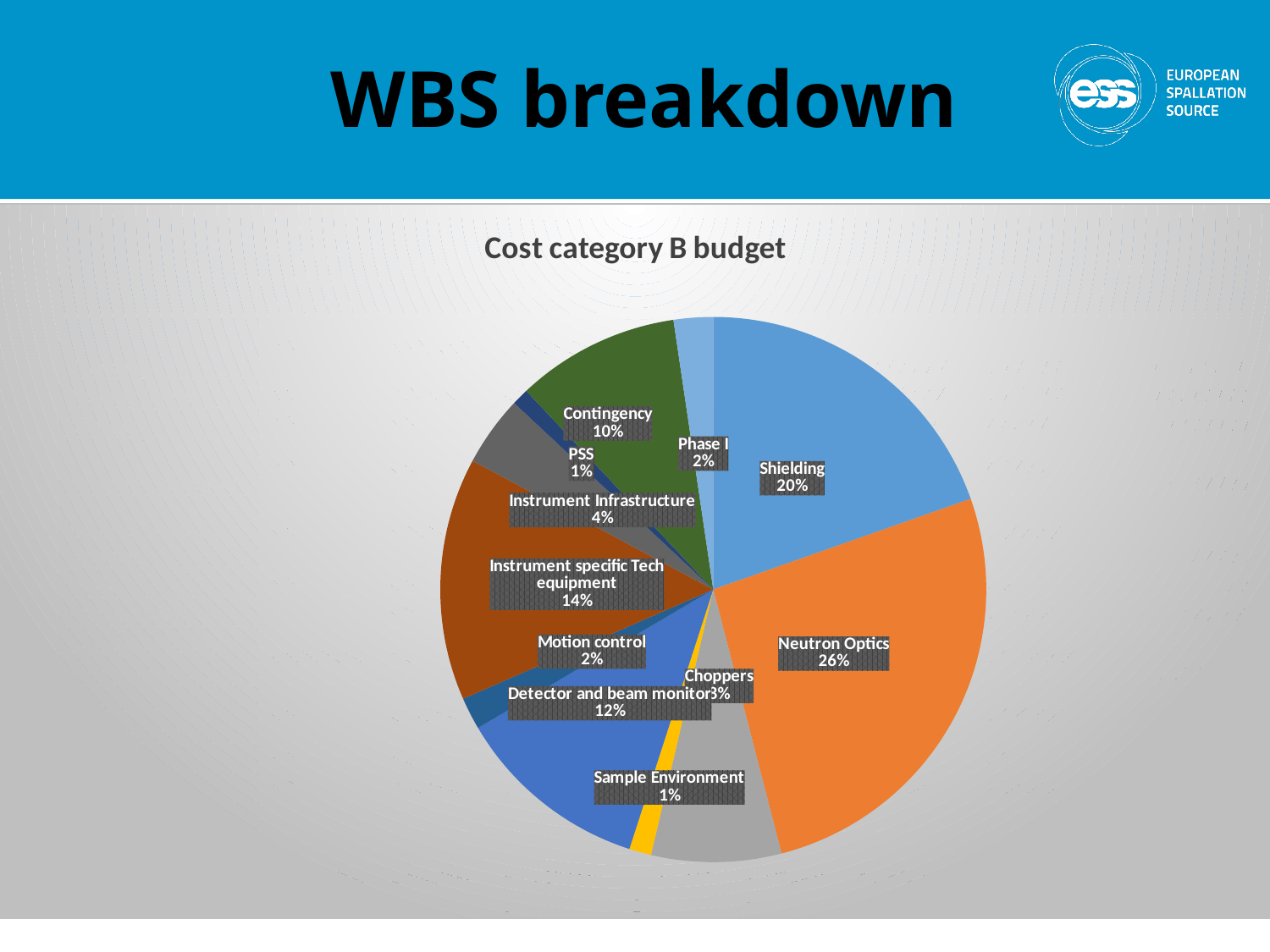
What percentage is shown for Shielding? 20% What percentage is shown for Instrument specific Tech equipment? 14% What type of chart is shown on the slide? pie chart Which category has the largest share of the Cost category B budget? Neutron Optics Which is larger, the share for Shielding or the share for Instrument specific Tech equipment? Shielding What is the title of the chart? Cost category B budget What is the difference in percentage points between Neutron Optics and Shielding? 6 What percentage is shown for Contingency? 10% What share of the Cost category B budget is Neutron Optics? 26% What percentage is shown for Detector and beam monitor? 12% What percentage is shown for Choppers? 8% How many labeled slices does the pie chart have? 11